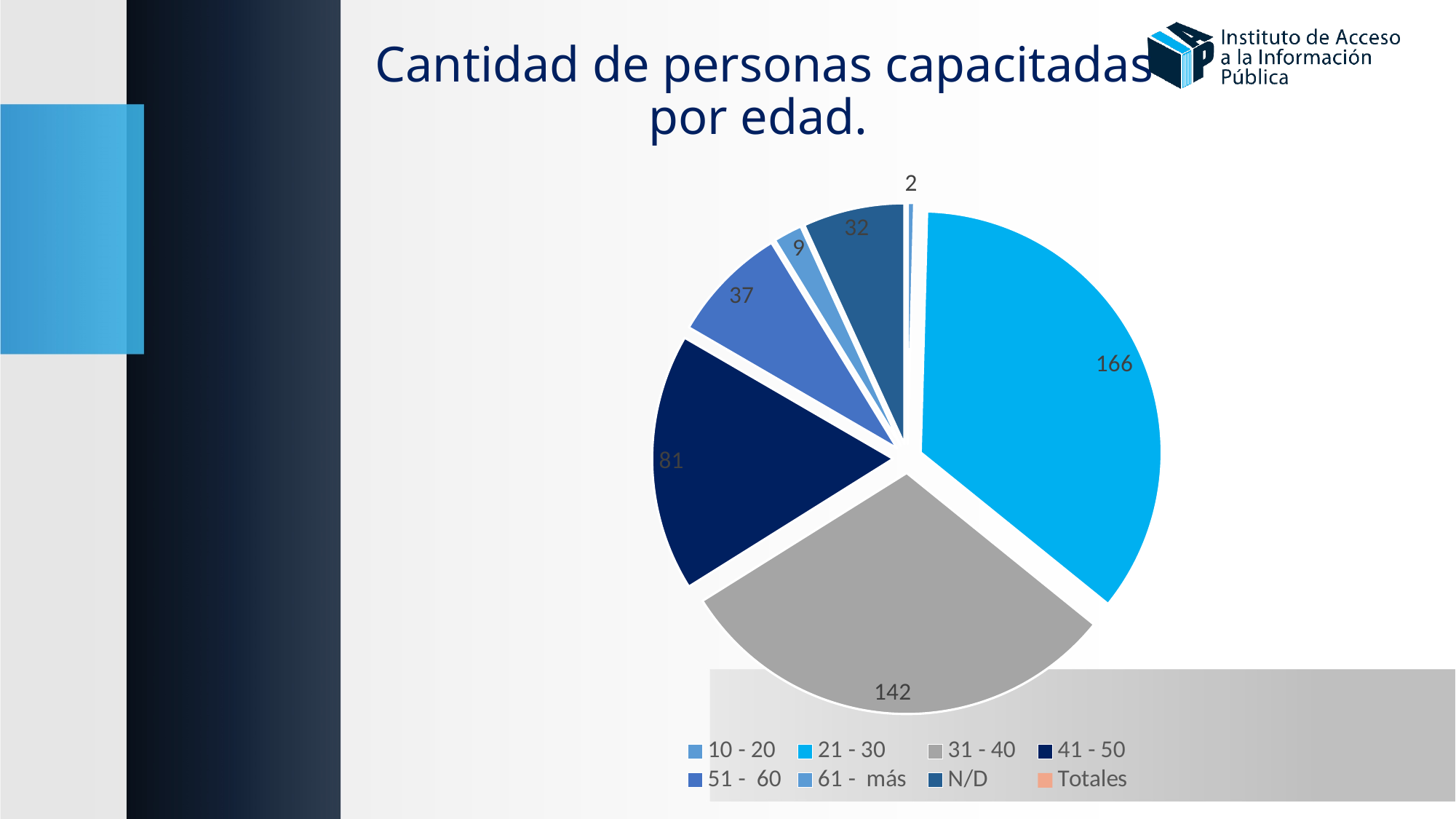
What is the value for the N/D category? 32 What is the difference between the values for the 21 - 30 and 31 - 40 age groups? 24 Which category has the smallest slice of the pie? 10 - 20 What is the title of the chart on the slide? Cantidad de personas capacitadas por edad. What is the value for the 41 - 50 age group? 81 What is the value for the 31 - 40 age group? 142 Which is larger, the value for 41 - 50 or the value for 51 - 60? 41 - 50 What is the value for the 61 - más age group? 9 What is the value for the 21 - 30 age group? 166 What kind of chart is shown on the slide? pie chart How many entries does the legend list? 8 Which age group has the largest slice of the pie? 21 - 30